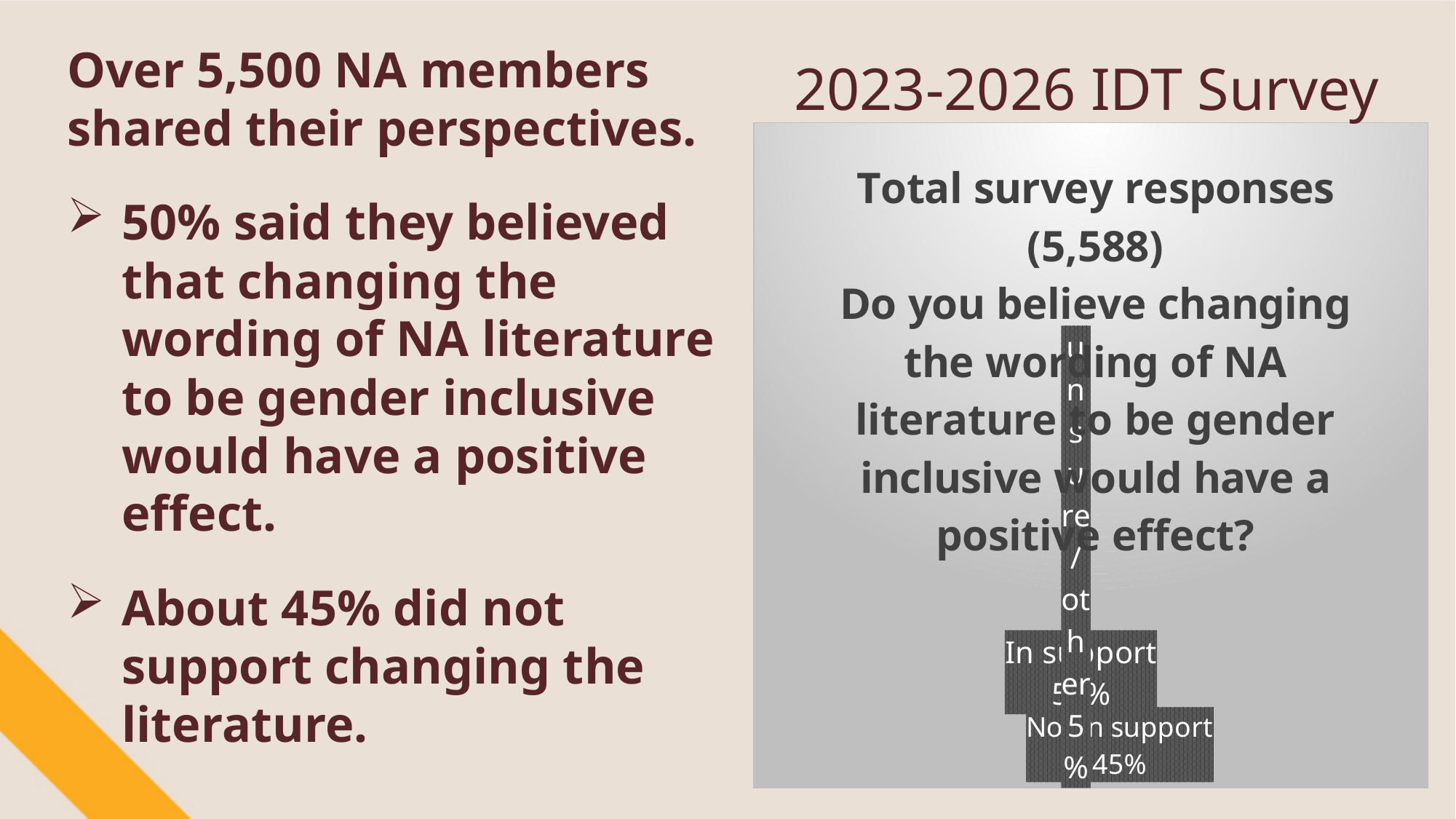
How many total survey responses does the chart title report? 5,588 Which response category has the largest share: 'In support' or 'Not in support'? In support Which response category has the largest share on the chart? In support Is the share for 'Not in support' greater or less than 50%? less What percentage of responses were 'Not in support' in the 2023-2026 IDT Survey chart? 45% How many response categories are labelled on the chart? 3 What question does the chart say respondents were asked? Do you believe changing the wording of NA literature to be gender inclusive would have a positive effect? Which response category has the smallest share on the chart? Unsure/other